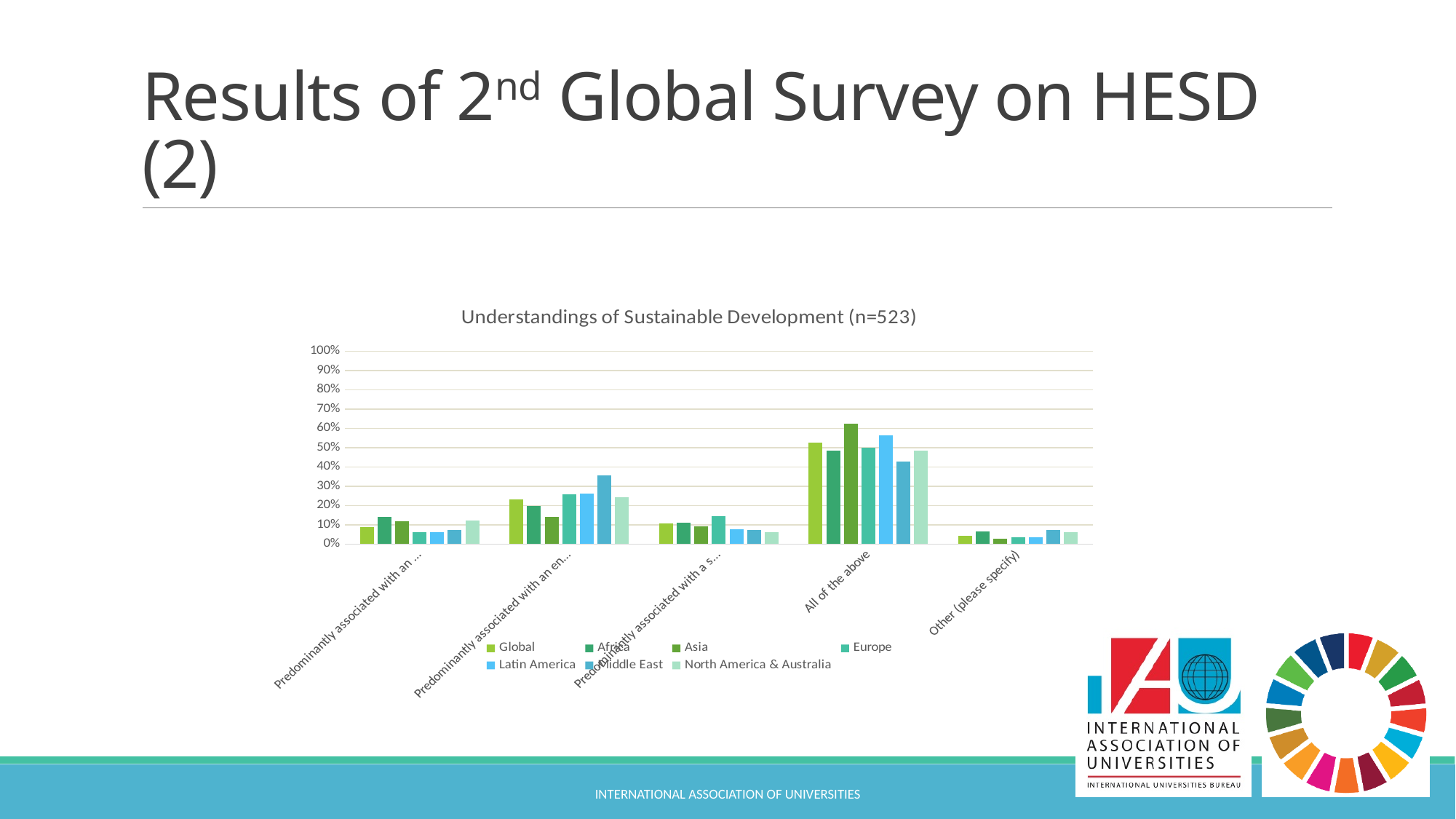
How many categories are shown along the x axis of the chart? 5 In the 'All of the above' category, which is larger: the value for Asia or the value for Middle East? Asia Is the value for Middle East in the 'All of the above' category greater or less than 50%? less Which series is listed first in the chart legend? Global Which category has the highest bars in the chart? All of the above What is the title of the chart? Understandings of Sustainable Development (n=523) How many series does the chart legend list? 7 Which category has the lowest bars in the chart? Other (please specify) In the 'All of the above' category, which series has the highest value? Asia Is the value for Asia in the 'All of the above' category greater or less than 50%? greater Is the value for Global in the 'Other (please specify)' category greater or less than 10%? less What kind of chart is shown on the slide? bar chart